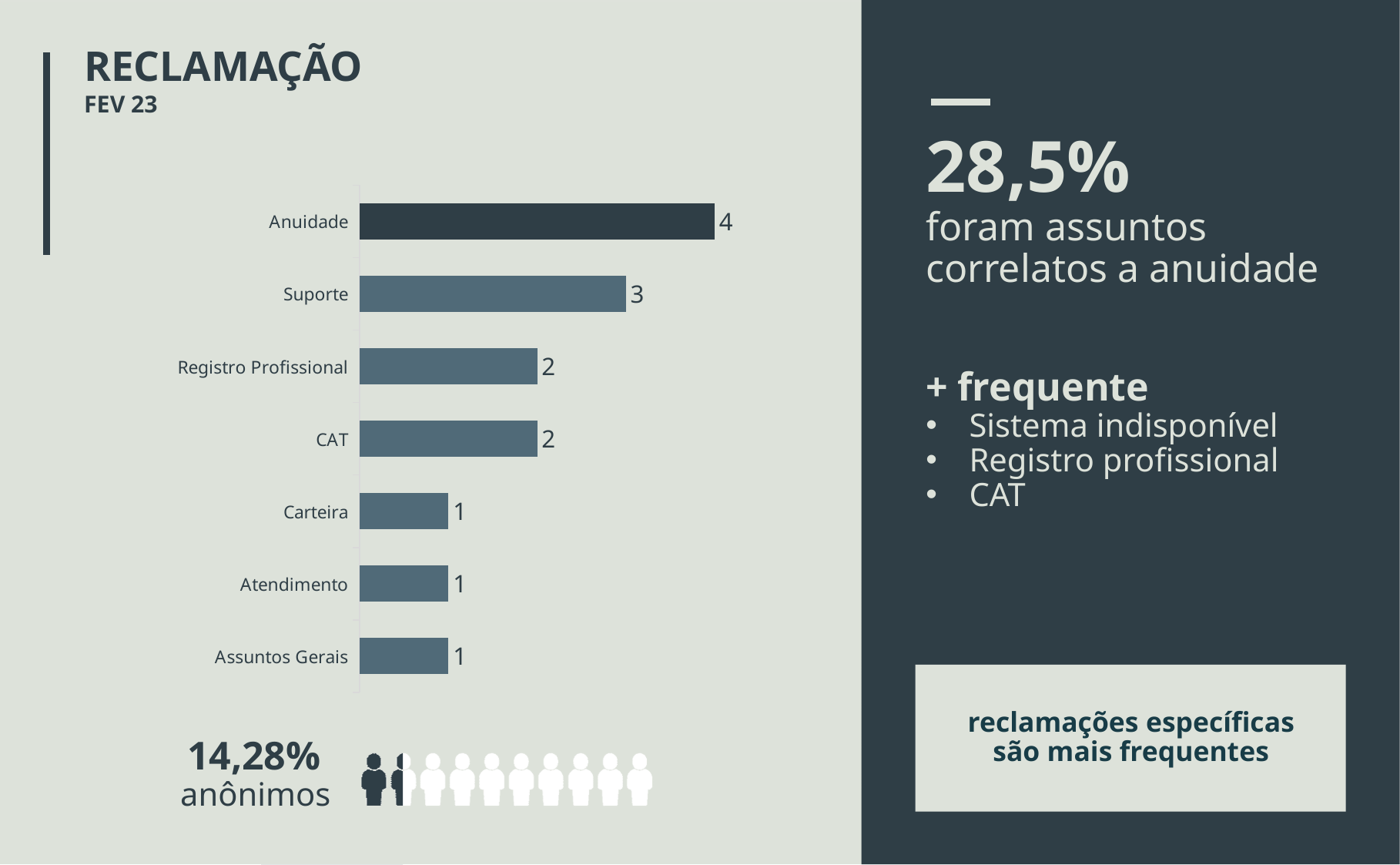
Which bar is shown in a darker colour than the others? Anuidade What is the difference between the values for Anuidade and Suporte? 1 Which category has the highest value? Anuidade What is the difference between the values for Suporte and Assuntos Gerais? 2 Which is larger, the value for Suporte or the value for CAT? Suporte What is the value for Carteira? 1 What is the value for Registro Profissional? 2 What is the value for Anuidade? 4 What kind of chart is shown on the slide? Bar chart What is the value for Suporte? 3 What is the total of all the values shown in the chart? 14 How many categories are shown in the chart? 7